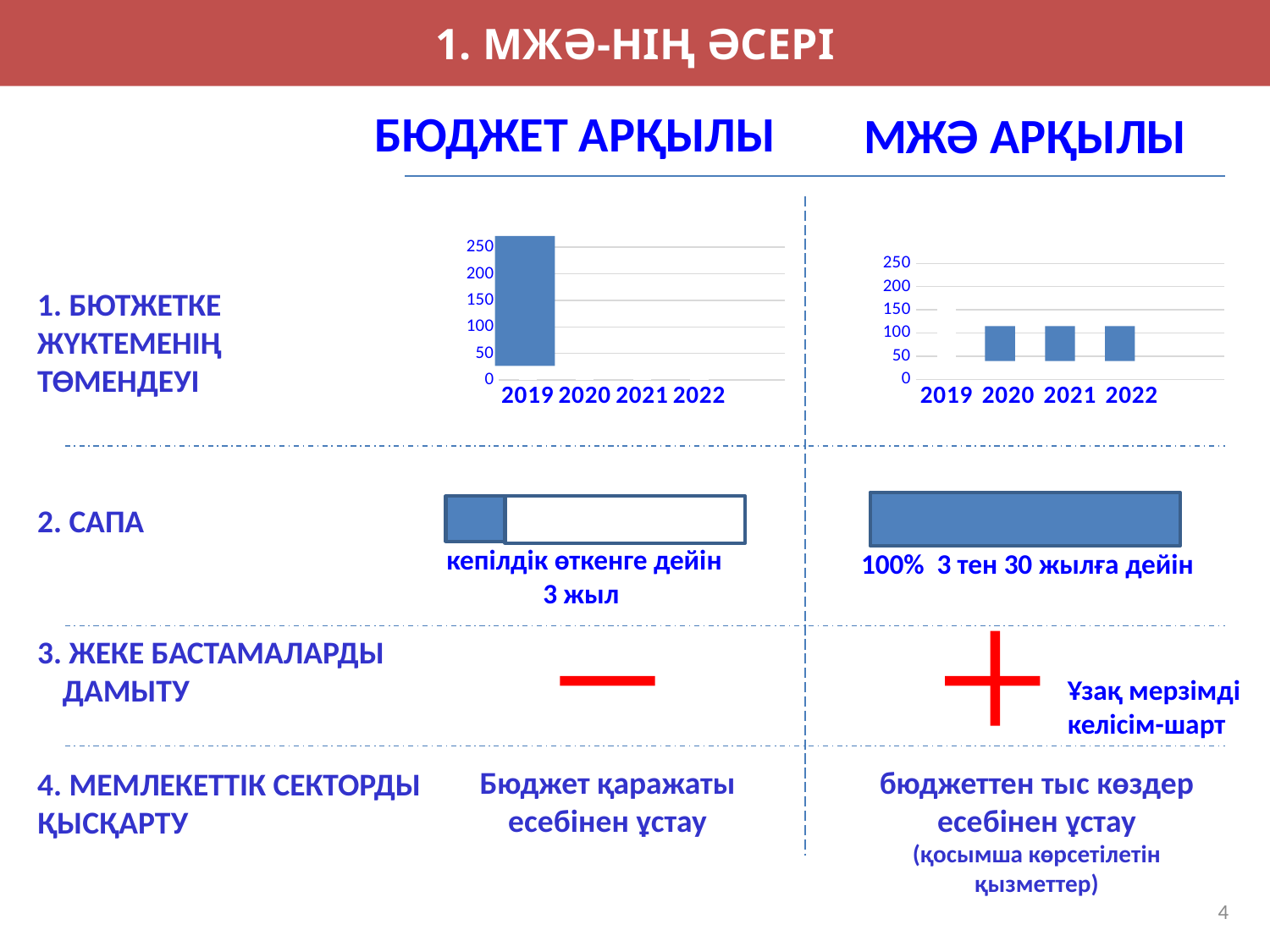
In the left chart (БЮДЖЕТ АРҚЫЛЫ), how many years are listed on the x axis? 4 In the right chart (МЖӘ АРҚЫЛЫ), is the value for 2022 greater or less than 150? less What kind of chart is shown under the heading "МЖӘ АРҚЫЛЫ" (right chart)? bar chart In the right chart (МЖӘ АРҚЫЛЫ), how many years have a visible bar? 3 In the left chart (БЮДЖЕТ АРҚЫЛЫ), which year has the highest bar? 2019 In the left chart (БЮДЖЕТ АРҚЫЛЫ), is the value for 2019 greater or less than 200? greater What kind of chart is shown under the heading "БЮДЖЕТ АРҚЫЛЫ" (left chart)? bar chart In the left chart (БЮДЖЕТ АРҚЫЛЫ), does the value rise or fall from 2019 to 2020? fall In the right chart (МЖӘ АРҚЫЛЫ), which year has the lowest value? 2019 What is the highest tick value shown on the y axis of the right chart (МЖӘ АРҚЫЛЫ)? 250 In the right chart (МЖӘ АРҚЫЛЫ), how many years are listed on the x axis? 4